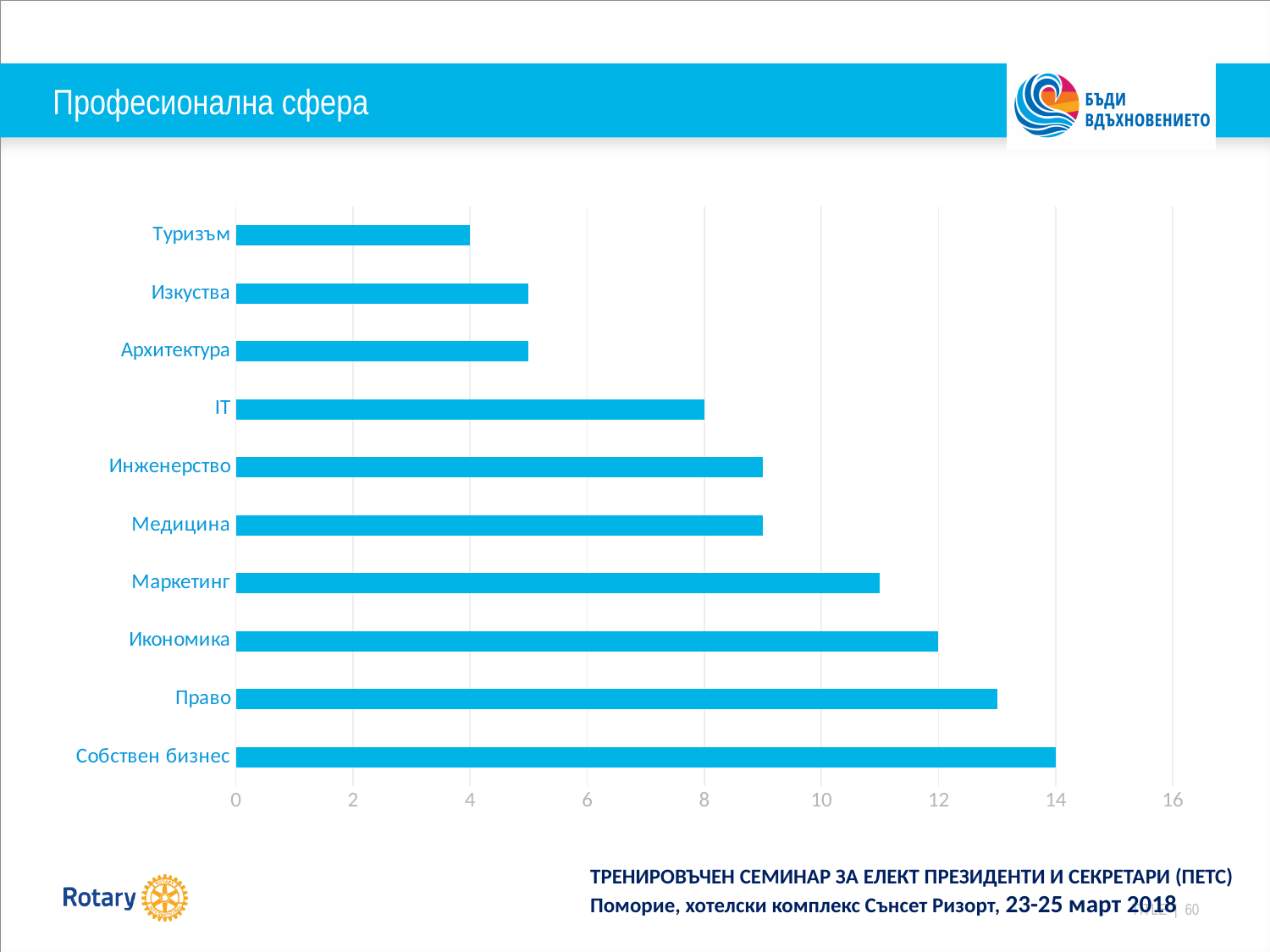
What is the difference between the values for Собствен бизнес and Туризъм? 10 How many categories are shown in the chart? 10 Which category has the highest value in the chart? Собствен бизнес What is the value for Туризъм? 4 What is the title of the slide containing the chart? Професионална сфера Which category has the lowest value in the chart? Туризъм What is the value for IT? 8 Is the value for Инженерство greater or less than 8? greater What is the value for Собствен бизнес? 14 What kind of chart is shown on the slide? bar chart Which is larger, the value for Право or the value for Маркетинг? Право What is the value for Икономика? 12